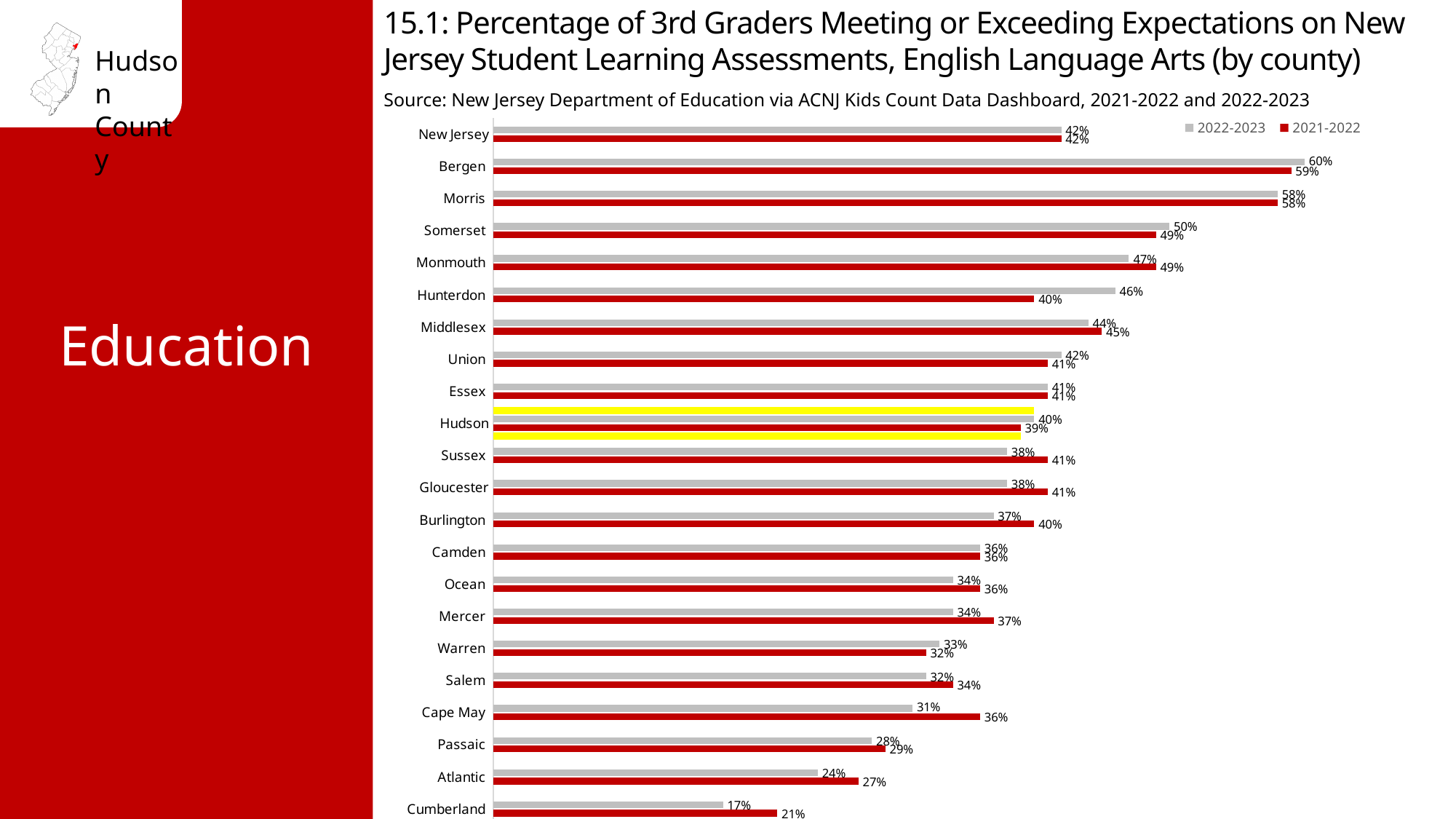
Which is larger for Monmouth: the 2022-2023 value or the 2021-2022 value? 2021-2022 How many series does the legend list? 2 Which series is shown in red? 2021-2022 What is the difference between the 2022-2023 and 2021-2022 values for Hunterdon? 6 percentage points What is the 2021-2022 value for Hunterdon? 40% What is the 2022-2023 value for Hudson? 40% Which county has the highest 2022-2023 value? Bergen How many counties or regions are listed on the chart? 22 What kind of chart is shown? Bar chart What is the difference between the 2021-2022 and 2022-2023 values for Cape May? 5 percentage points What is the 2022-2023 value for Cape May? 31% Which county has the lowest 2021-2022 value? Cumberland